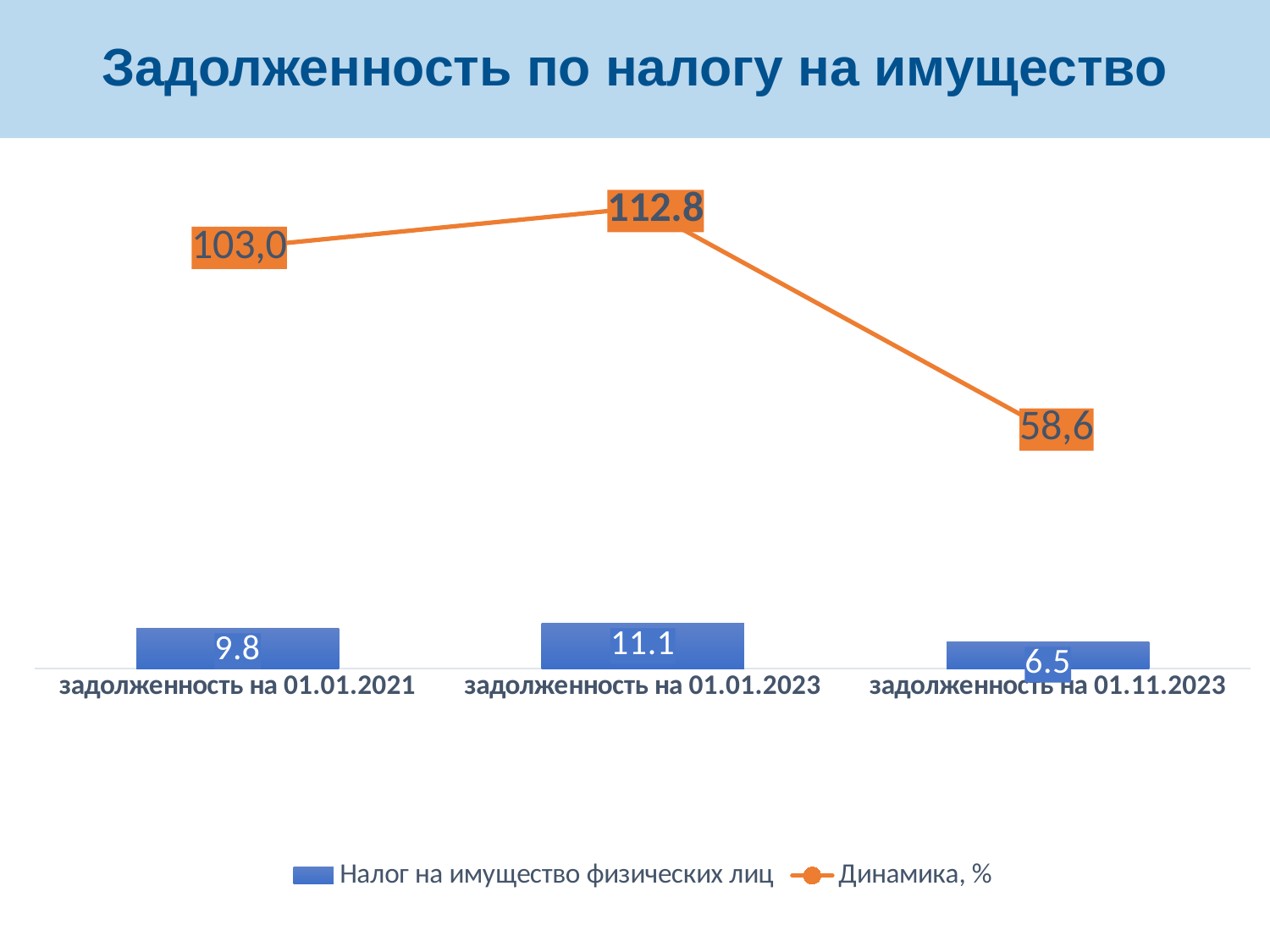
How many categories are shown on the x axis? 3 What is the difference between the bar values for задолженность на 01.01.2023 and задолженность на 01.11.2023? 4.6 What is the value of the bar for задолженность на 01.01.2023? 11.1 Which category has the lowest Динамика, % value? задолженность на 01.11.2023 What is the Динамика, % value for задолженность на 01.01.2023? 112.8 What is the Динамика, % value for задолженность на 01.11.2023? 58,6 How many series does the legend list? 2 Which category has the highest bar value for Налог на имущество физических лиц? задолженность на 01.01.2023 What is the value of the bar for задолженность на 01.01.2021? 9.8 Which is larger, the Динамика, % value for задолженность на 01.01.2021 or for задолженность на 01.01.2023? задолженность на 01.01.2023 What is the title of the chart? Задолженность по налогу на имущество What is the value of the bar for задолженность на 01.11.2023? 6.5